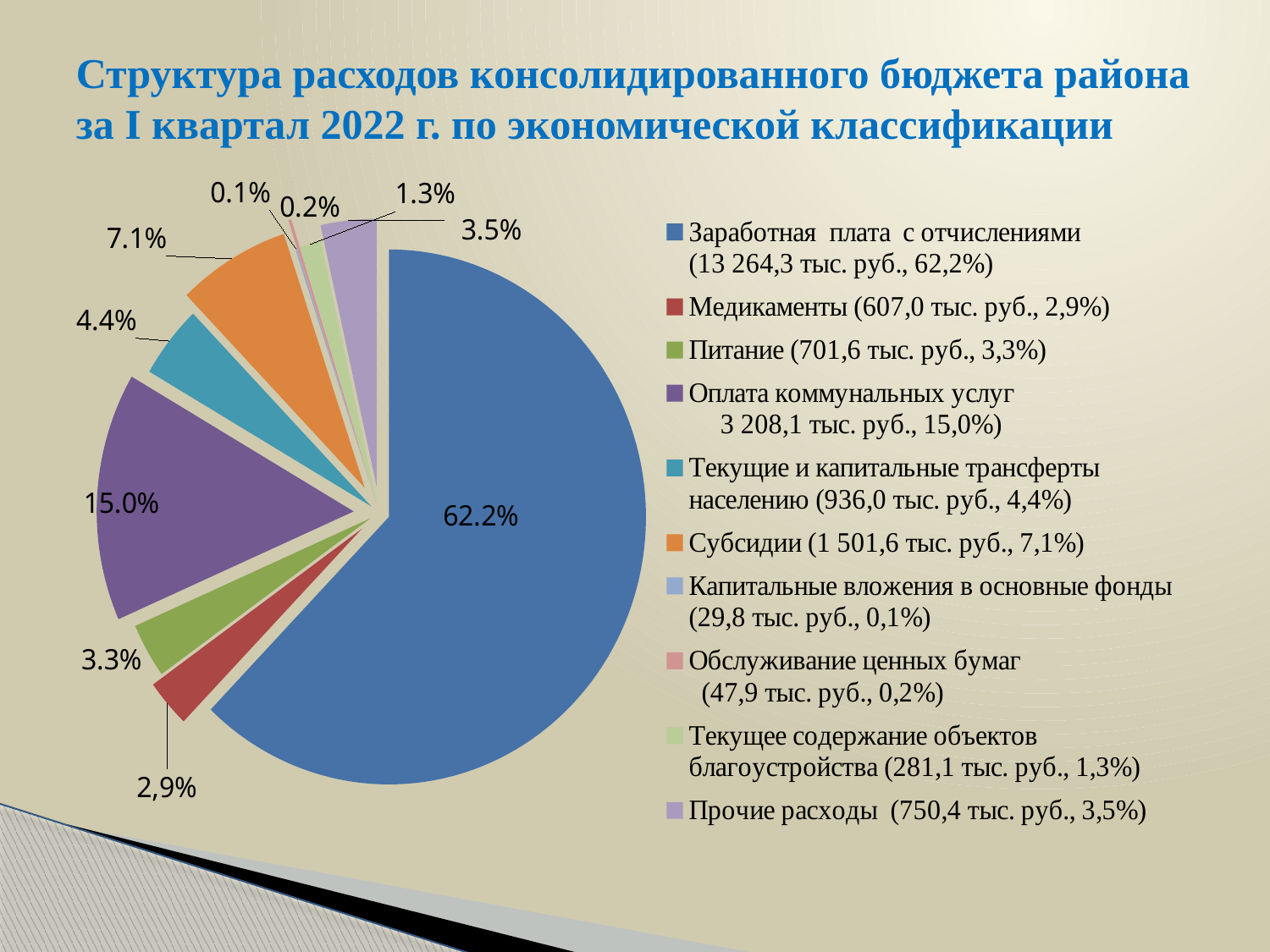
According to the legend, what is the amount for "Медикаменты"? 607,0 тыс. руб. How many entries does the legend of the pie chart list? 10 What share of the pie does "Заработная плата с отчислениями" take? 62.2% What is the difference in percentage points between the "Заработная плата с отчислениями" slice (62.2%) and the "Оплата коммунальных услуг" slice (15.0%)? 47.2% Which category has the smallest slice of the pie? Капитальные вложения в основные фонды What share of the pie does "Субсидии" take? 7.1% Which slice is larger: "Субсидии" or "Текущие и капитальные трансферты населению"? Субсидии According to the legend, what is the amount for "Субсидии"? 1 501,6 тыс. руб. How many slices does the pie chart have? 10 What share of the pie does "Оплата коммунальных услуг" take? 15.0% Which category has the largest slice of the pie? Заработная плата с отчислениями What kind of chart is shown on the slide? Pie chart